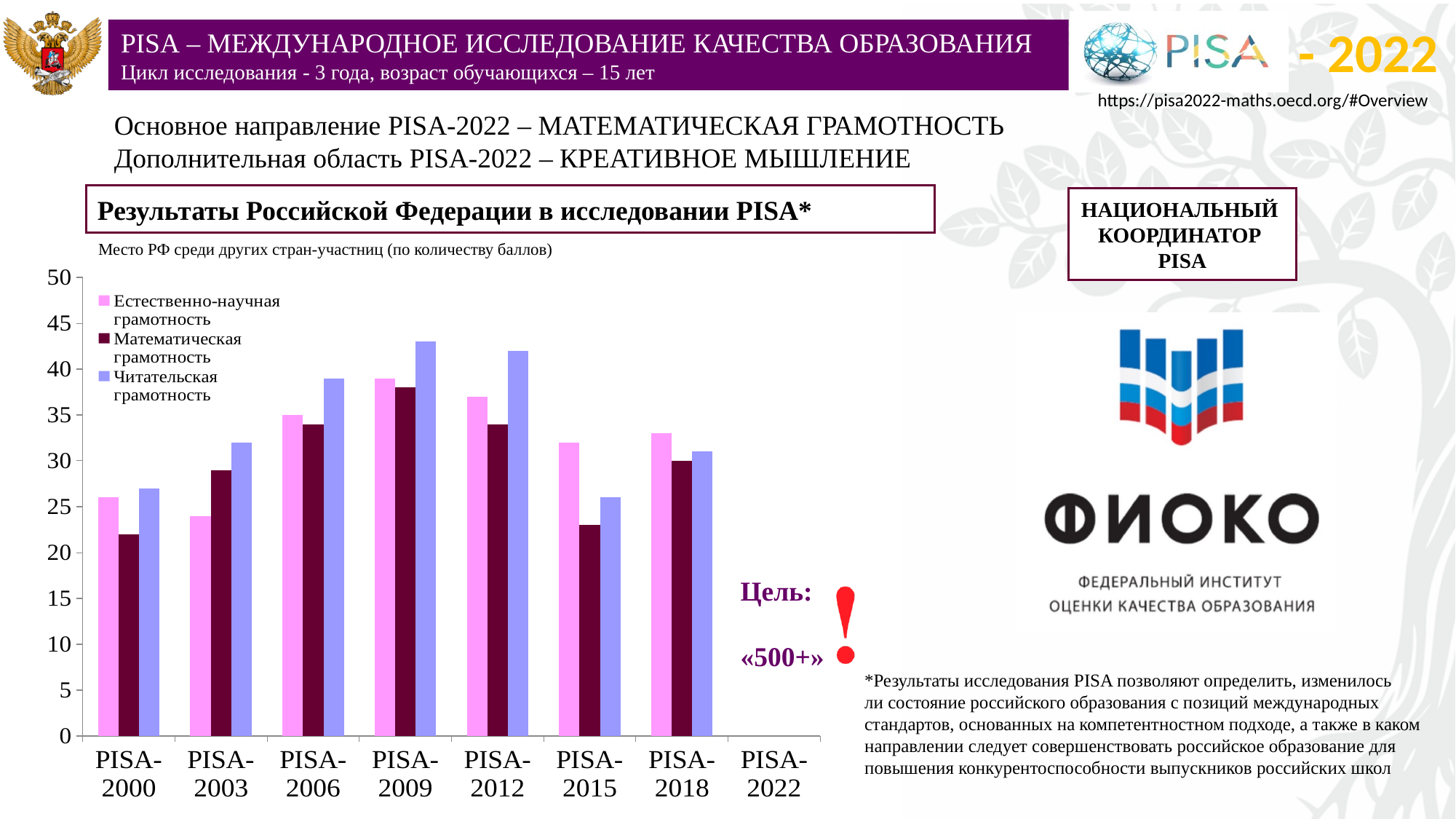
Which PISA cycle has the highest value for Математическая грамотность? PISA-2009 Is the value for Математическая грамотность in PISA-2015 greater or less than 25? less Which PISA cycle has the highest value for Читательская грамотность? PISA-2009 Which is larger: Читательская грамотность in PISA-2012 or in PISA-2015? PISA-2012 How many series does the chart legend list? 3 Is the value for Читательская грамотность in PISA-2009 greater or less than 40? greater How many PISA cycles are labelled on the x axis of the chart? 8 Which colour represents Математическая грамотность in the chart legend? dark purple Does the value for Читательская грамотность rise or fall from PISA-2000 to PISA-2009? rise What kind of chart is shown on the slide? bar chart Which PISA cycle has the lowest value for Естественно-научная грамотность? PISA-2003